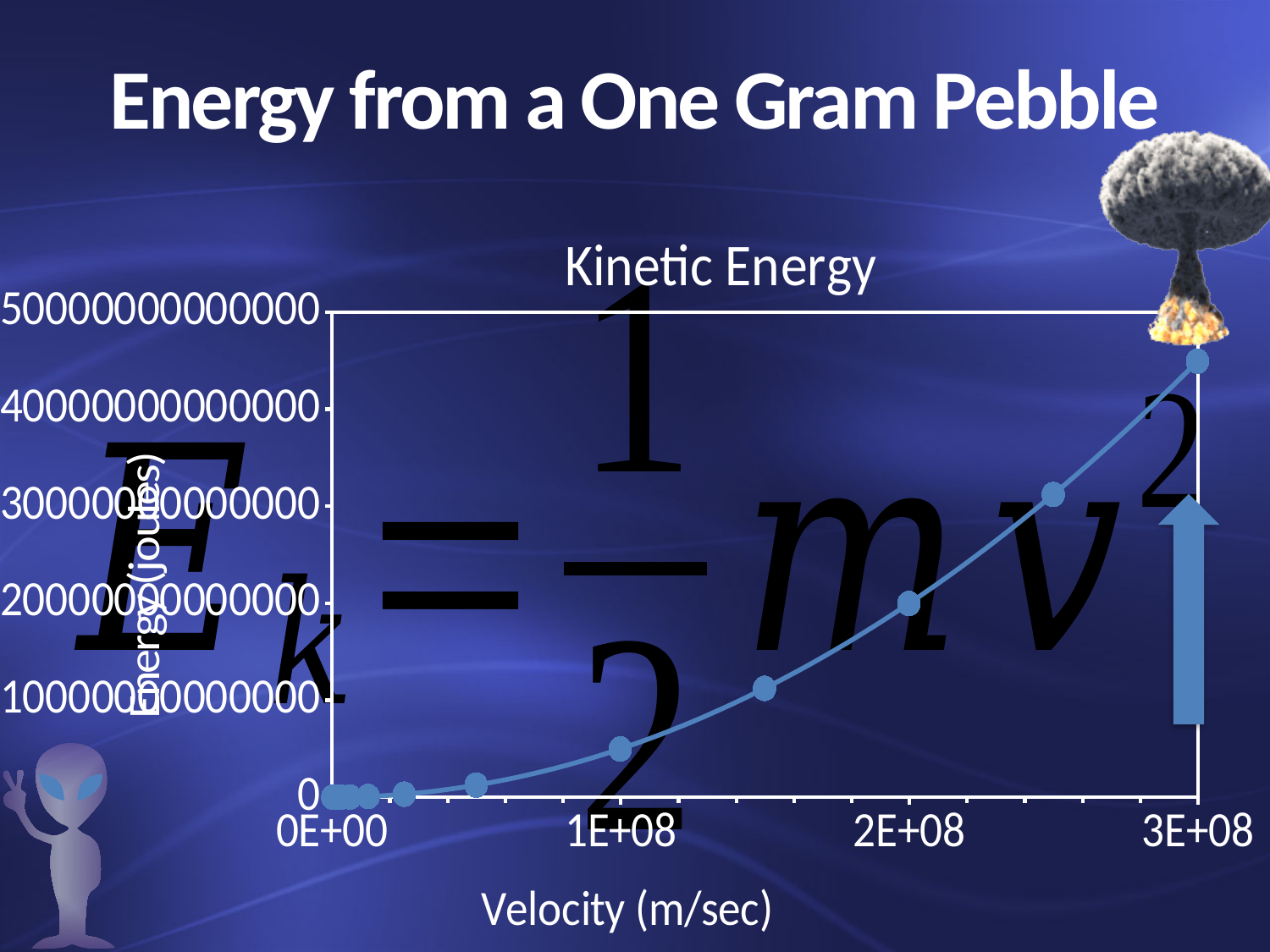
What kind of chart is shown on the slide? scatter chart with a smooth line Which has the larger energy value: a velocity of 2E+08 or a velocity of 1E+08? 2E+08 At which velocity is the plotted energy highest? 3E+08 Do the energy values rise or fall as velocity increases along the x axis? rise At which velocity is the plotted energy lowest? 0E+00 Is the energy value at a velocity of 3E+08 greater or less than 40000000000000? greater What is the label of the x axis of the chart? Velocity (m/sec) What is the title of the chart? Kinetic Energy Which has the larger energy value: a velocity of 1E+08 or a velocity of 3E+08? 3E+08 Is the energy value at a velocity of 2.5E+08 greater or less than 20000000000000? greater Is the energy value at a velocity of 1.5E+08 greater or less than 20000000000000? less